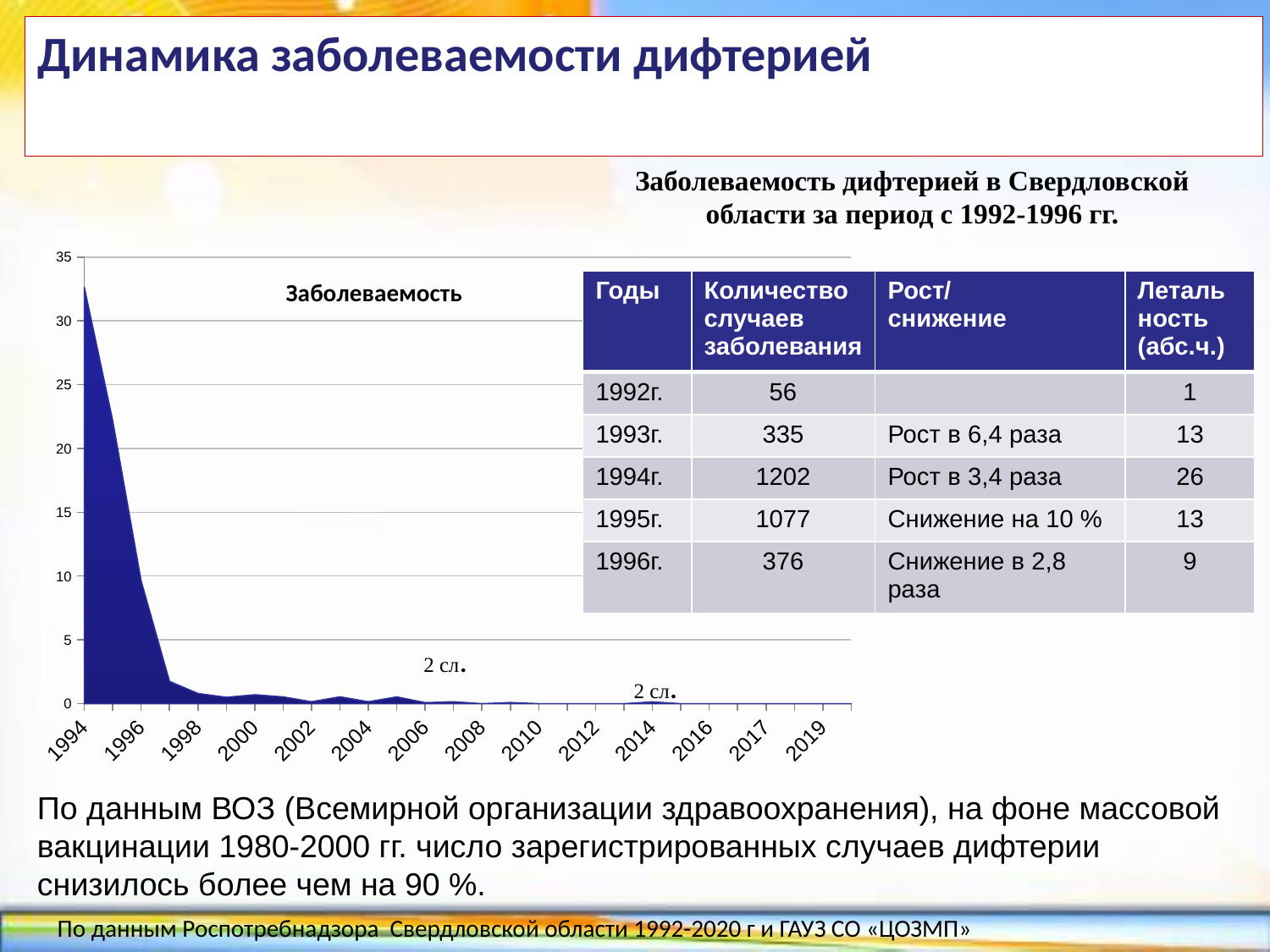
How many year labels are shown on the x axis of the chart? 14 What is the first year label on the x axis of the chart? 1994 Which year on the x axis has the highest value in the chart? 1994 Which year has the larger value, 1996 or 2006? 1996 What is the title of the chart? Заболеваемость Is the value for 1998 greater or less than 5? less Is the value for 1994 greater or less than 30? greater Is the value for 2010 greater or less than 5? less What is the highest value shown on the y axis of the chart? 35 What kind of chart is shown on the slide? area chart Do the values in the chart rise or fall from 1994 to 2019? fall Which year has the larger value, 1994 or 2000? 1994